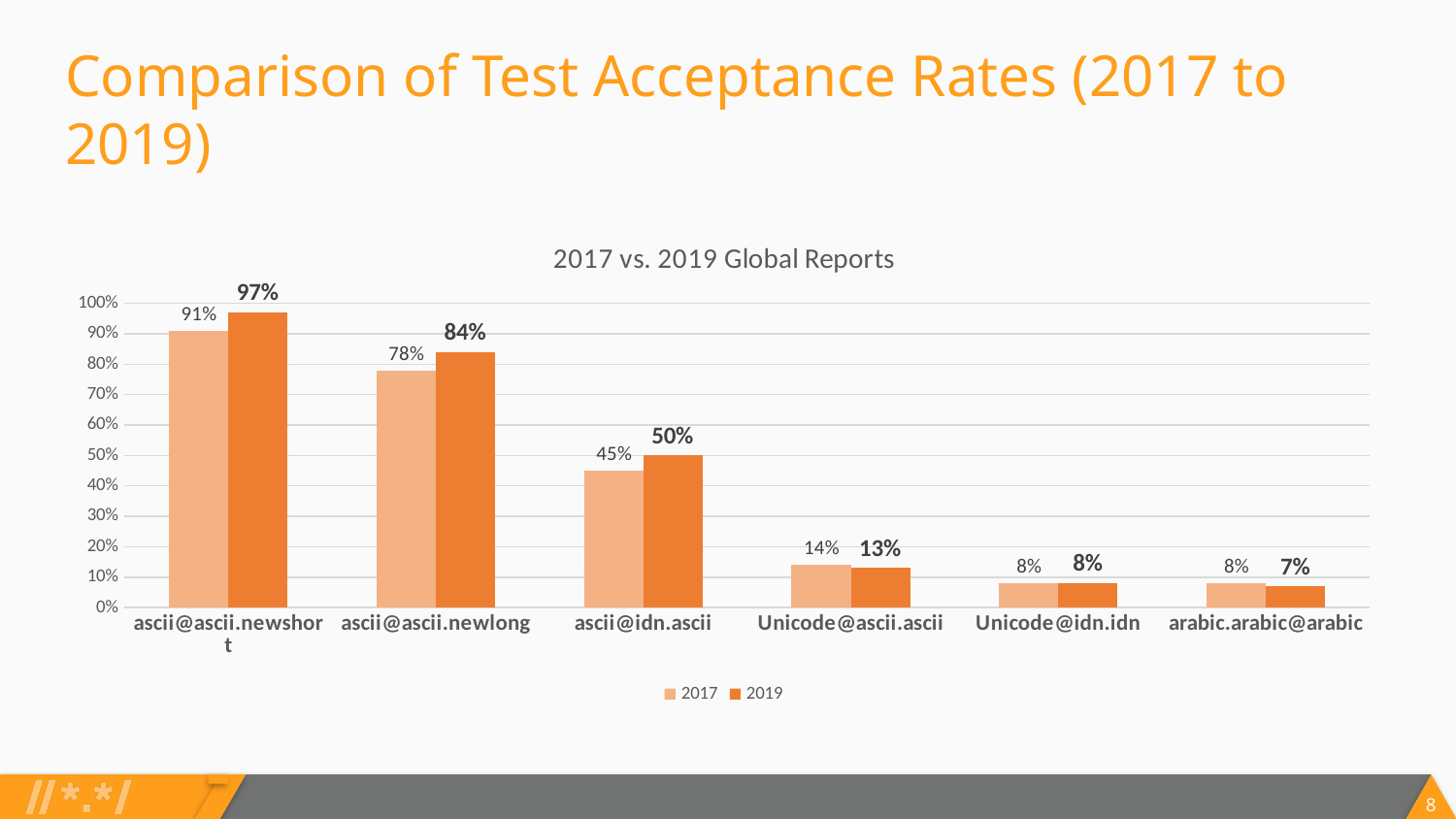
How many series does the legend list? 2 Which category has the highest 2019 value? ascii@ascii.newshort What is the difference between the 2017 values for ascii@ascii.newlong and ascii@idn.ascii? 33% What is the title of the chart? 2017 vs. 2019 Global Reports How many categories are shown on the x axis? 6 Which category has the lowest 2019 value? arabic.arabic@arabic What is the 2017 value for ascii@idn.ascii? 45% What is the 2017 value for Unicode@ascii.ascii? 14% What kind of chart is shown on the slide? bar chart What is the 2019 value for ascii@ascii.newlong? 84% Which is larger for Unicode@ascii.ascii, the 2017 value or the 2019 value? 2017 What is the difference between the 2019 and 2017 values for ascii@ascii.newshort? 6%